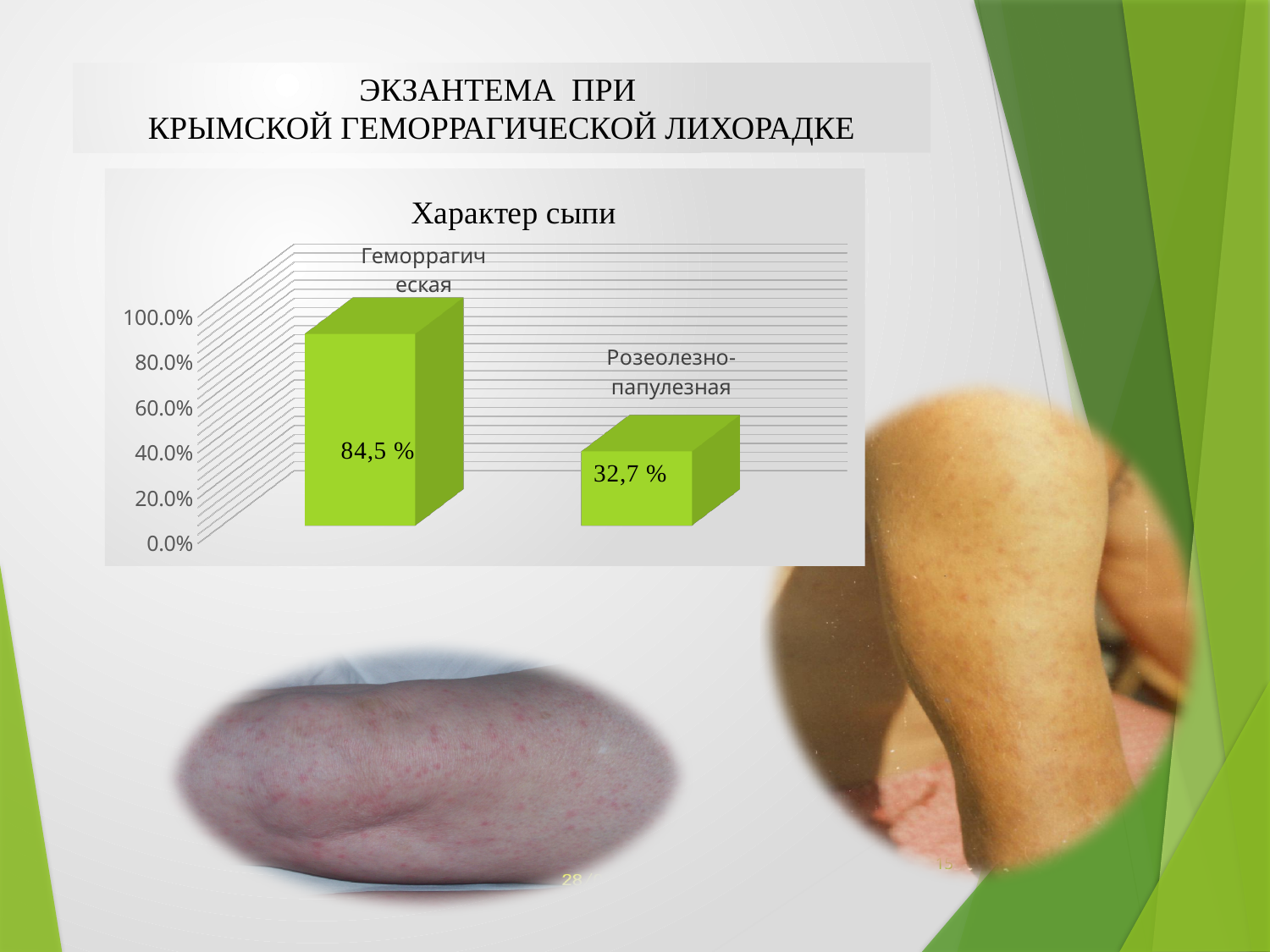
What type of chart is shown on the slide? bar chart What is the title of the chart? Характер сыпи What is the value for Розеолезно-папулезная? 32,7 % Which is larger, the value for Геморрагическая or for Розеолезно-папулезная? Геморрагическая What is the value for Геморрагическая? 84,5 % Which category has the highest value? Геморрагическая Is the value for Розеолезно-папулезная greater or less than 40.0%? less How many categories are shown in the chart? 2 What is the maximum value shown on the vertical axis? 100.0% Which category has the lowest value? Розеолезно-папулезная What is the difference between the values for Геморрагическая and Розеолезно-папулезная? 51,8 % Is the value for Геморрагическая greater or less than 80.0%? greater